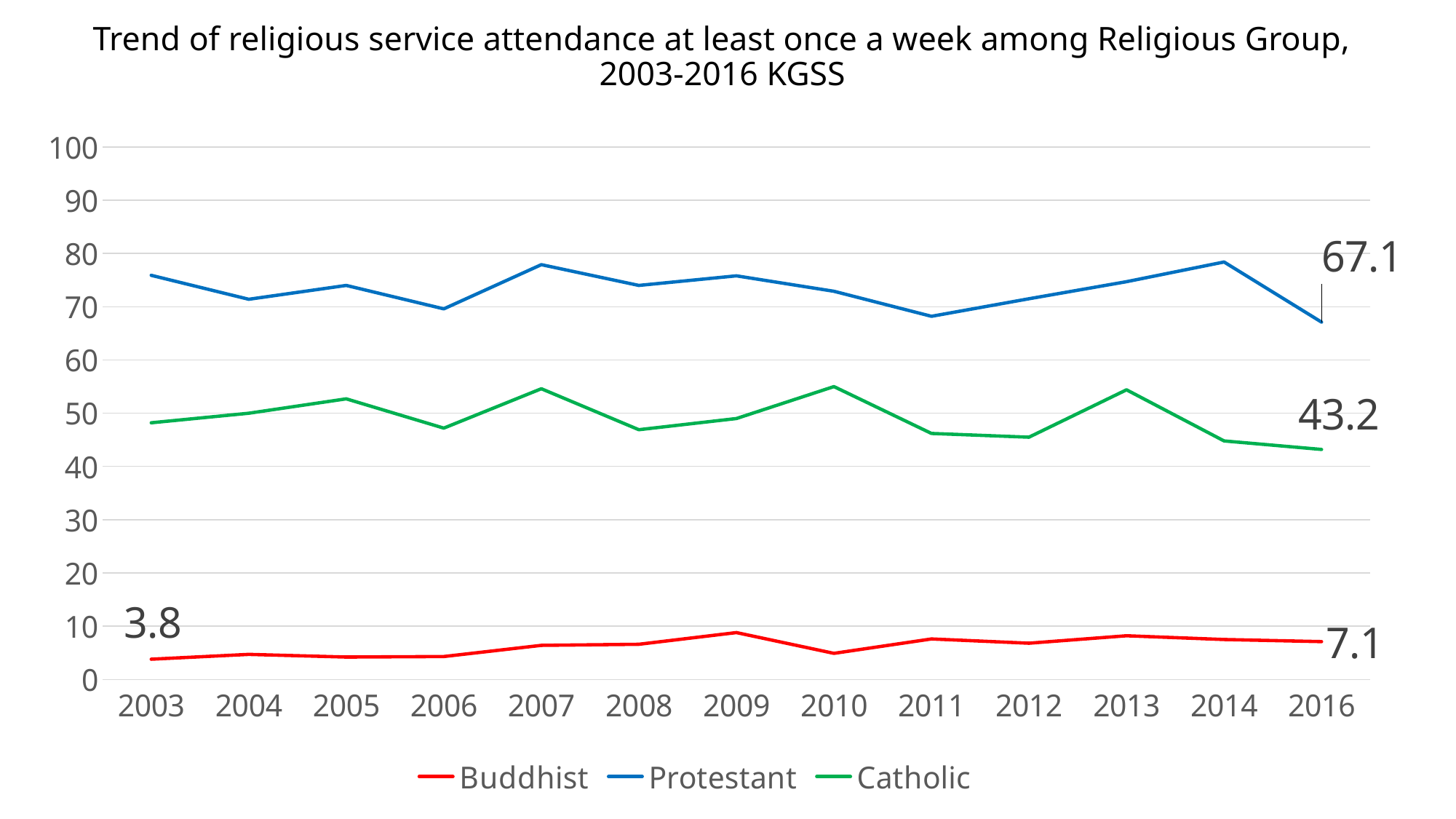
What is the difference between the Protestant and Catholic values in 2016? 23.9 What is the value for Buddhist in 2003? 3.8 How many years are shown along the x axis? 13 Which series has the higher value in 2016, Protestant or Catholic? Protestant What kind of chart is shown on the slide? line chart What is the value for Catholic in 2016? 43.2 By how much did the Buddhist value change from 2003 to 2016? 3.3 Which series has the highest values throughout the chart? Protestant What is the value for Protestant in 2016? 67.1 How many series does the legend list? 3 Is the value for Protestant in 2014 greater or less than 70? greater What is the value for Buddhist in 2016? 7.1